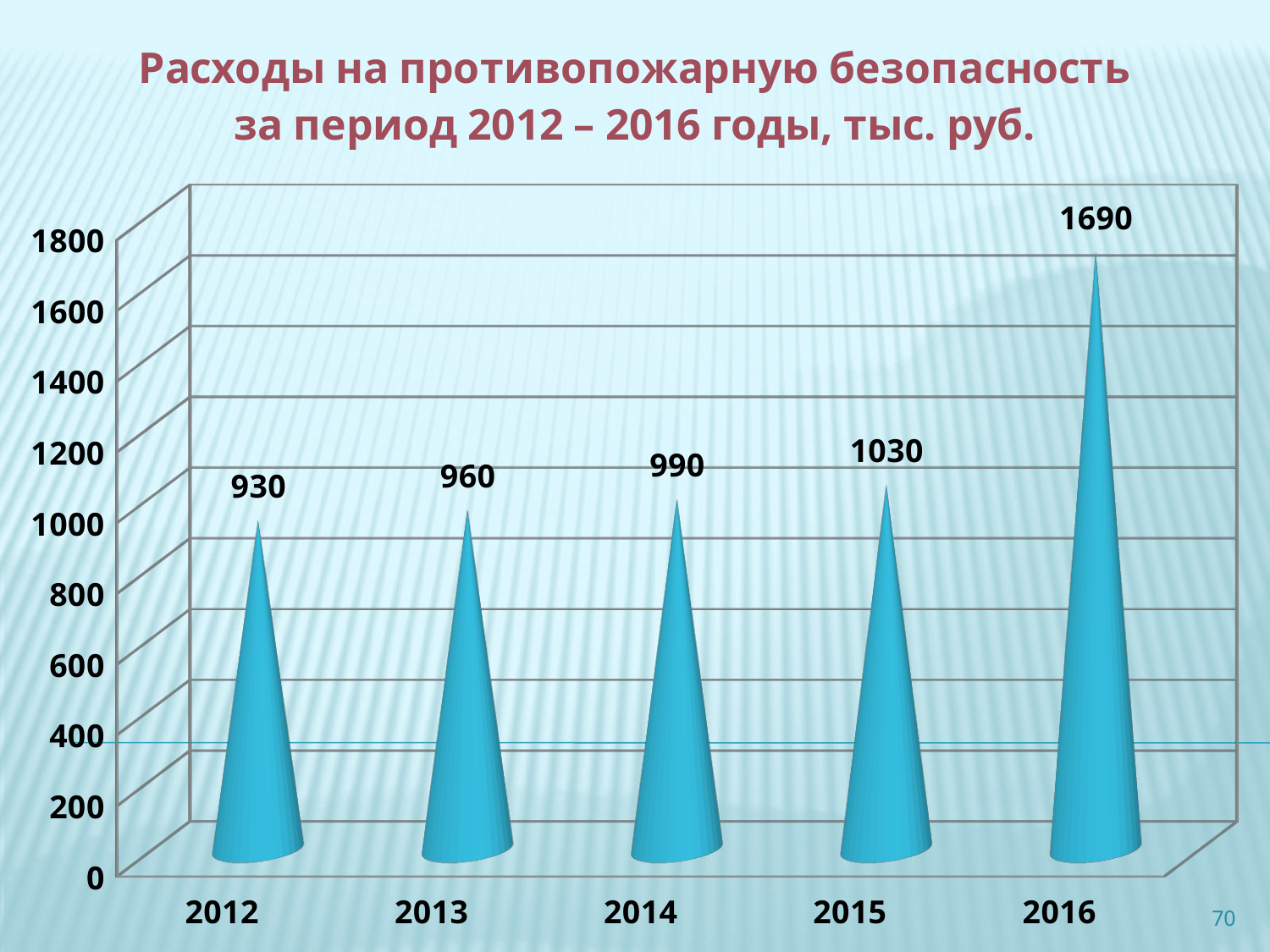
How many years are shown on the x axis? 5 What is the value for 2012? 930 What kind of chart is this? bar chart What is the difference between the values for 2013 and 2012? 30 Which is larger, the value for 2015 or the value for 2013? 2015 Which year has the lowest value? 2012 Is the value for 2016 greater or less than 1400? greater What is the difference between the values for 2016 and 2015? 660 Which year has the highest value? 2016 Do the values rise or fall from 2012 to 2016? rise What is the value for 2016? 1690 What is the value for 2014? 990